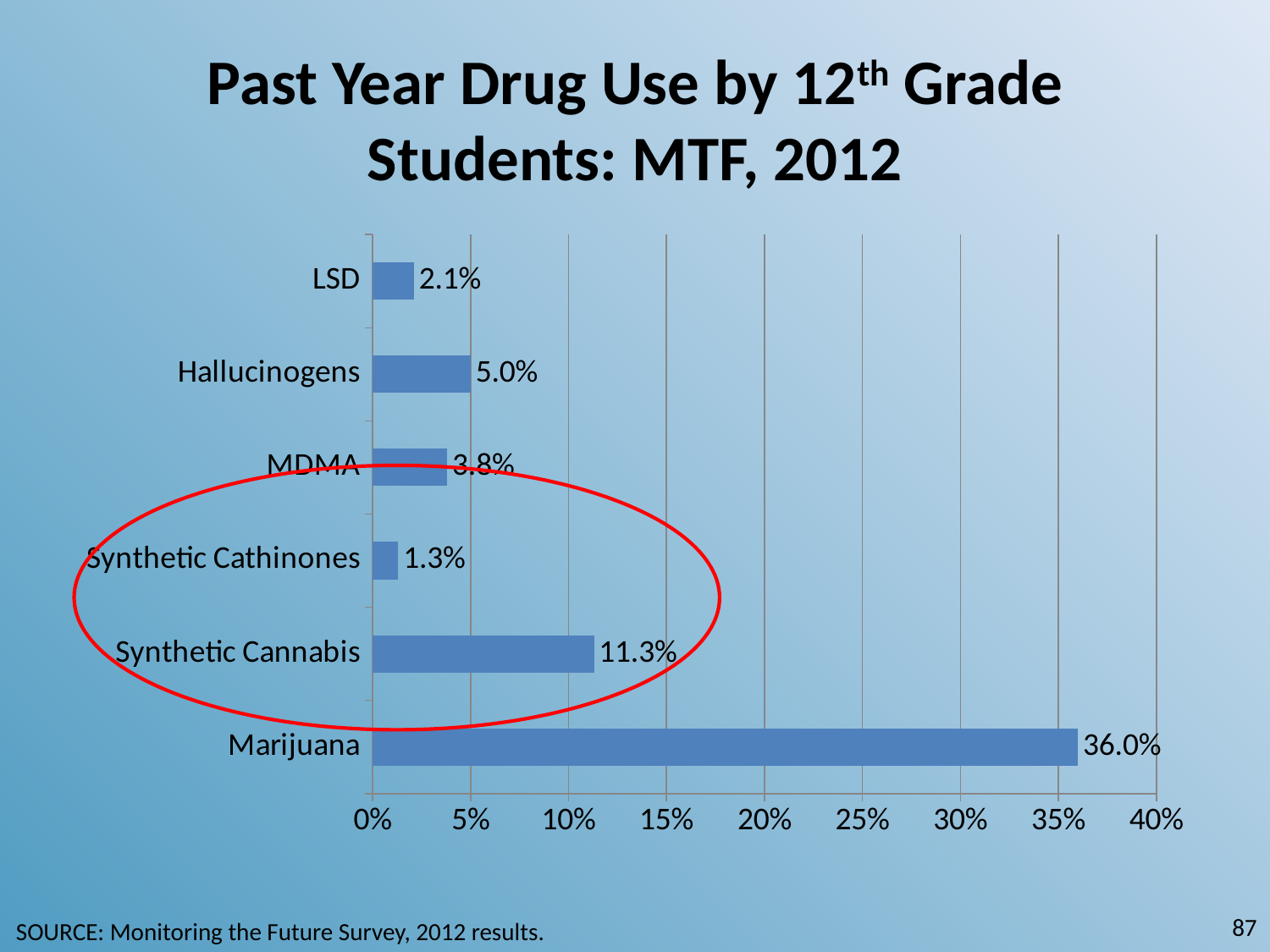
What is the value shown for Synthetic Cannabis? 11.3% Is the value for Synthetic Cannabis greater or less than 10%? greater Which drug has the lowest past year use value? Synthetic Cathinones What is the value shown for Synthetic Cathinones? 1.3% What is the value shown for Hallucinogens? 5.0% What is the difference between the values for Marijuana and Synthetic Cannabis? 24.7% What kind of chart is shown on the slide? Bar chart What is the past year use value for Marijuana? 36.0% How many drug categories are shown in the chart? 6 Which drug has the highest past year use value? Marijuana Which is larger, the value for Hallucinogens or the value for MDMA? Hallucinogens Which two categories are circled in red on the chart? Synthetic Cathinones and Synthetic Cannabis